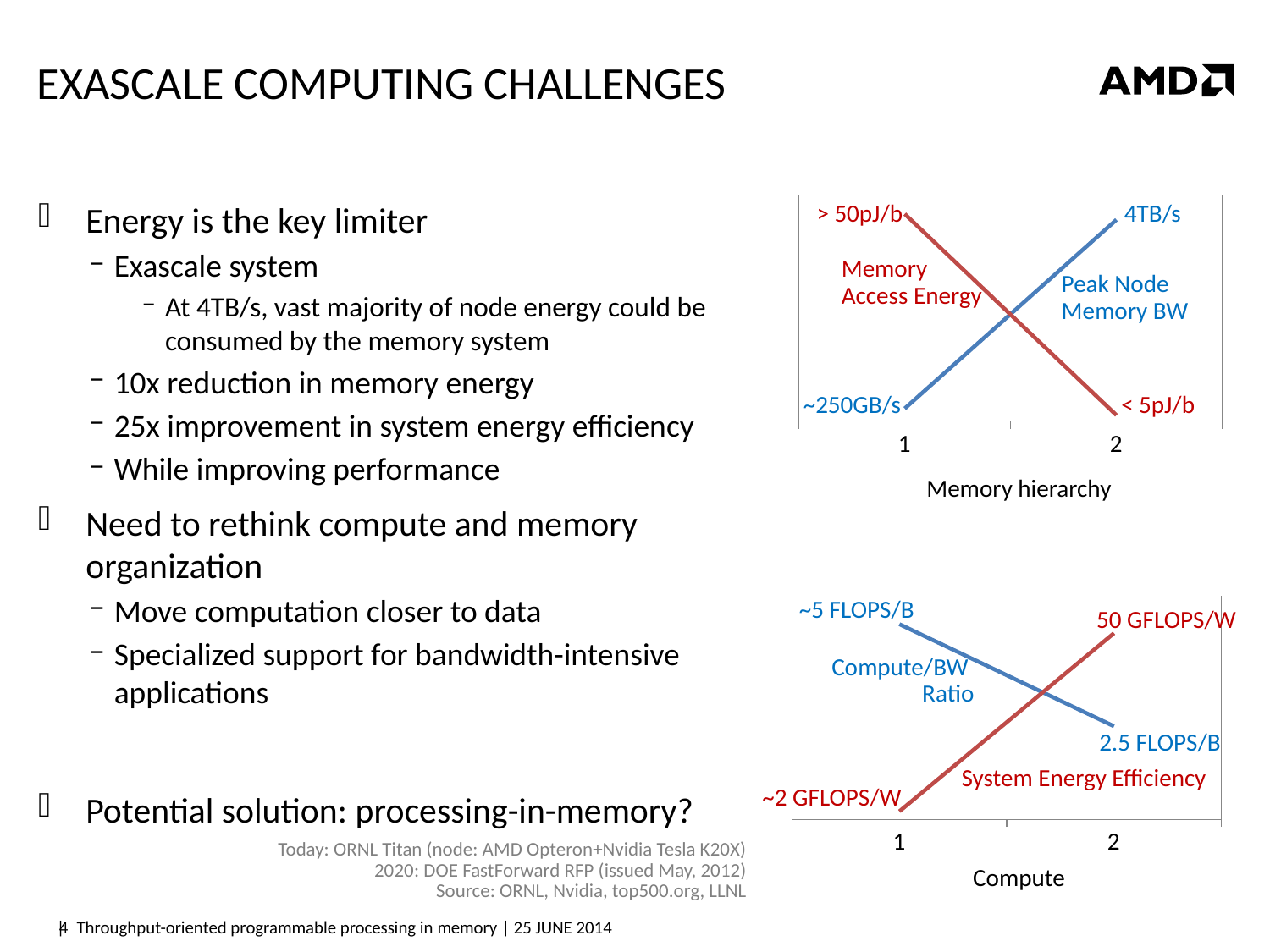
In the bottom chart (Compute), how many lines are plotted? 2 In the bottom chart (Compute), what colour is the System Energy Efficiency line? red In the top chart (Memory hierarchy), does Memory Access Energy rise or fall from x = 1 to x = 2? fall In the bottom chart (Compute), does System Energy Efficiency rise or fall from x = 1 to x = 2? rise In the top chart (Memory hierarchy), how many lines are plotted? 2 What kind of chart is the bottom chart labelled 'Compute'? line chart In the top chart (Memory hierarchy), what value is labelled for Peak Node Memory BW at x = 2? 4TB/s In the top chart (Memory hierarchy), does Peak Node Memory BW rise or fall from x = 1 to x = 2? rise In the top chart (Memory hierarchy), how many points are on the x axis? 2 In the bottom chart (Compute), what value is labelled for the Compute/BW Ratio at x = 2? 2.5 FLOPS/B What kind of chart is the top chart labelled 'Memory hierarchy'? line chart